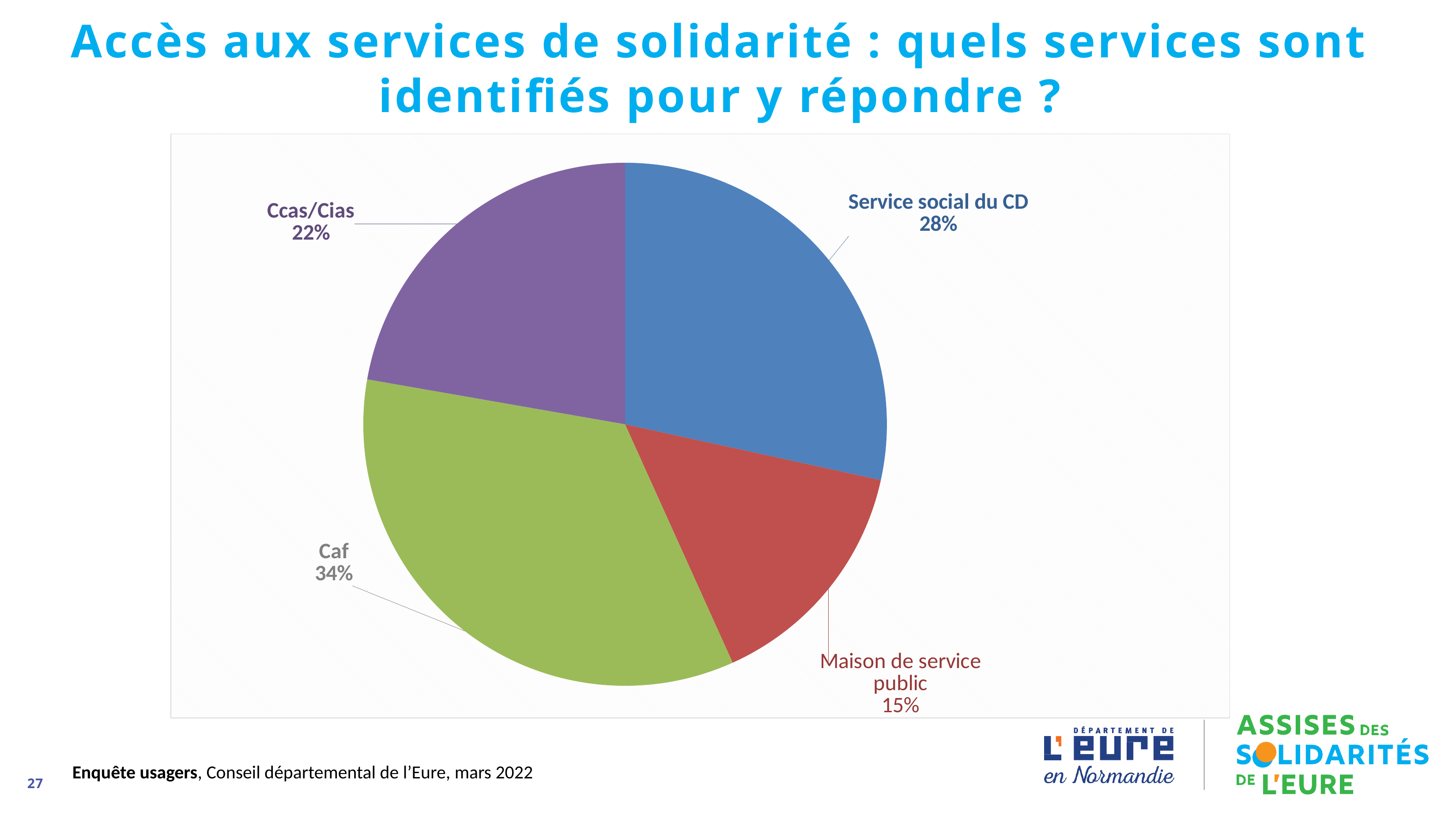
What share of the pie does Caf represent? 34% What is the difference in percentage points between Caf and Service social du CD? 6 What type of chart is shown on the slide? pie chart What is the value shown for Ccas/Cias? 22% What is the difference in percentage points between Ccas/Cias and Maison de service public? 7 Which category has the largest slice of the pie? Caf Which category has the smallest slice of the pie? Maison de service public What is the value shown for Maison de service public? 15% How many slices does the pie chart have? 4 What is the value shown for Service social du CD? 28% Which is larger, Ccas/Cias or Maison de service public? Ccas/Cias What colour is the slice for Caf? green